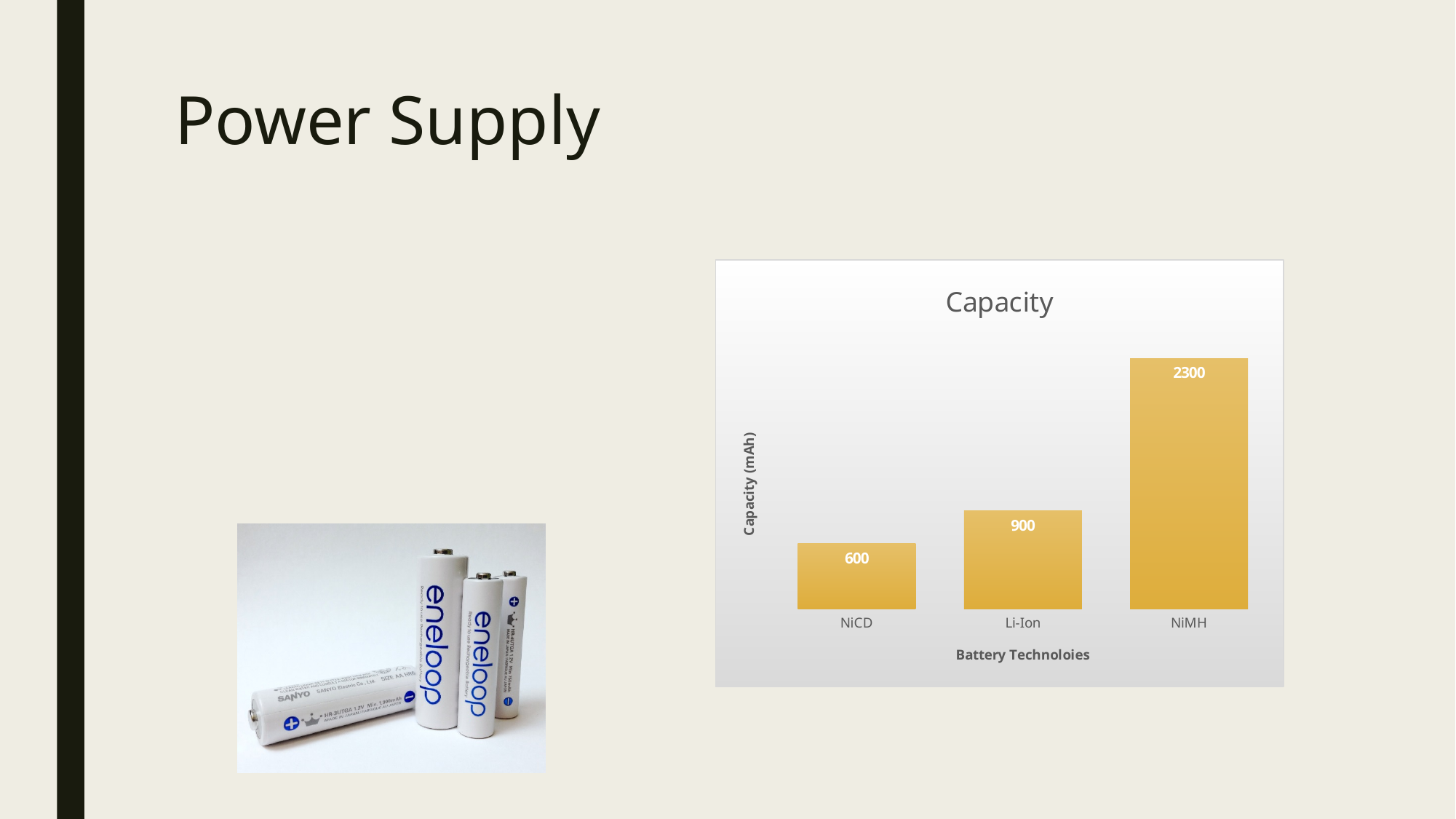
What is the difference in capacity between Li-Ion and NiCD? 300 Which battery technology has the lowest capacity? NiCD What is the capacity value shown for NiCD? 600 Which has a larger capacity, Li-Ion or NiCD? Li-Ion What is the capacity value shown for NiMH? 2300 What kind of chart is shown on the slide? Bar chart How many battery technologies are shown in the chart? 3 What is the difference in capacity between NiMH and Li-Ion? 1400 Which battery technology has the highest capacity? NiMH What is the title of the chart? Capacity What is the capacity value shown for Li-Ion? 900 Do the capacity values rise or fall from left to right across the x axis? Rise